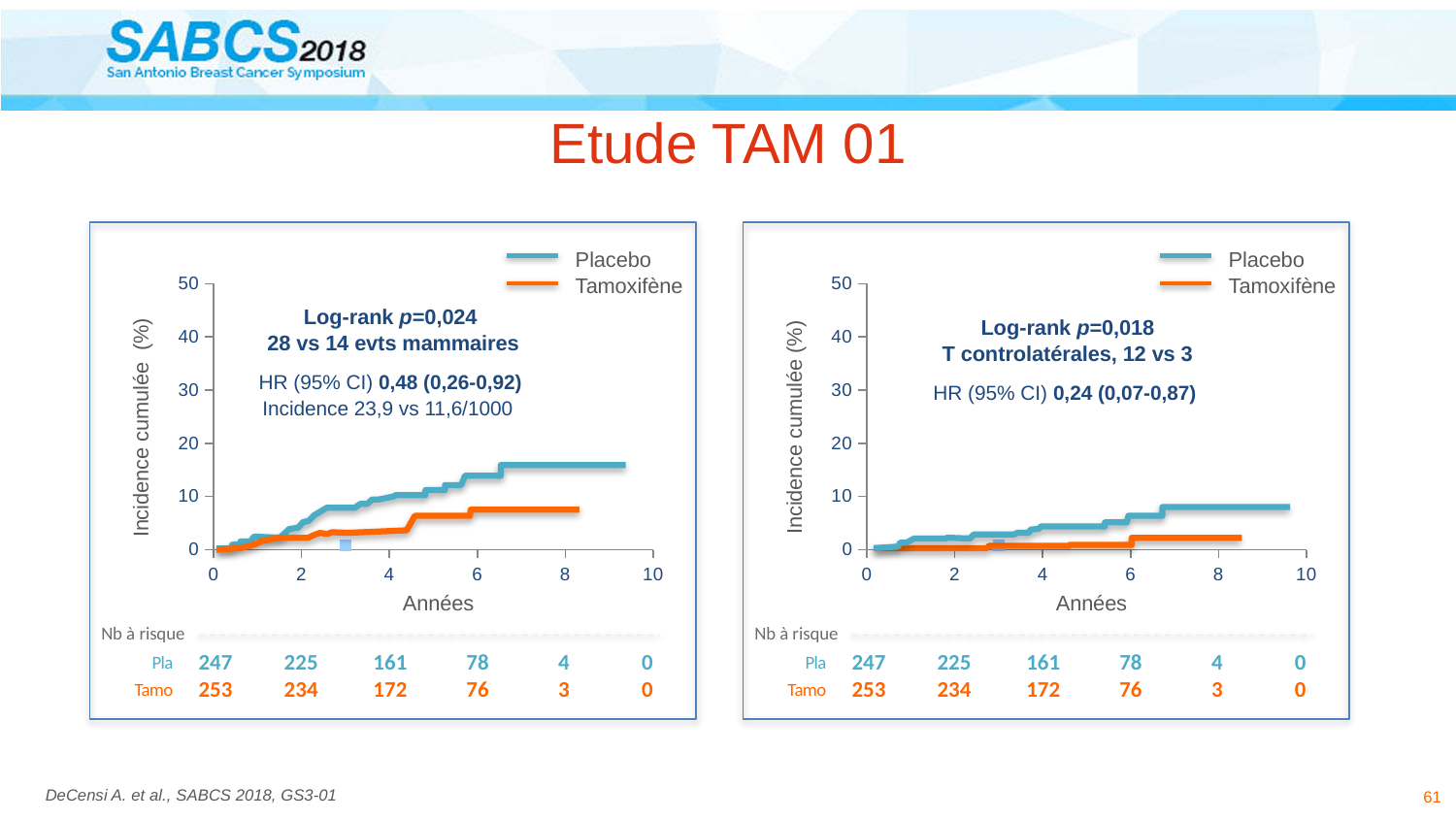
On the left chart, which curve is higher at 8 years, Placebo or Tamoxifène? Placebo On the right chart, what is the number at risk (Nb à risque) for Tamo at 2 years? 234 On the right chart, is the cumulative incidence for Placebo at 8 years greater or less than 10? less What kind of chart is the left chart on the slide? line chart On the left chart, is the cumulative incidence for Tamoxifène at 8 years greater or less than 10? less On the right chart, does the Placebo curve rise or fall as years increase? rise On the right chart, what is the difference between the number at risk for Tamo and for Pla at 0 years? 6 On the left chart, is the cumulative incidence for Placebo at 8 years greater or less than 10? greater How many time points are listed in the number-at-risk table below the left chart? 6 What are the two legend entries on the left chart? Placebo, Tamoxifène On the left chart, what is the number at risk (Nb à risque) for Pla at 4 years? 161 How many series does the legend of the right chart list? 2